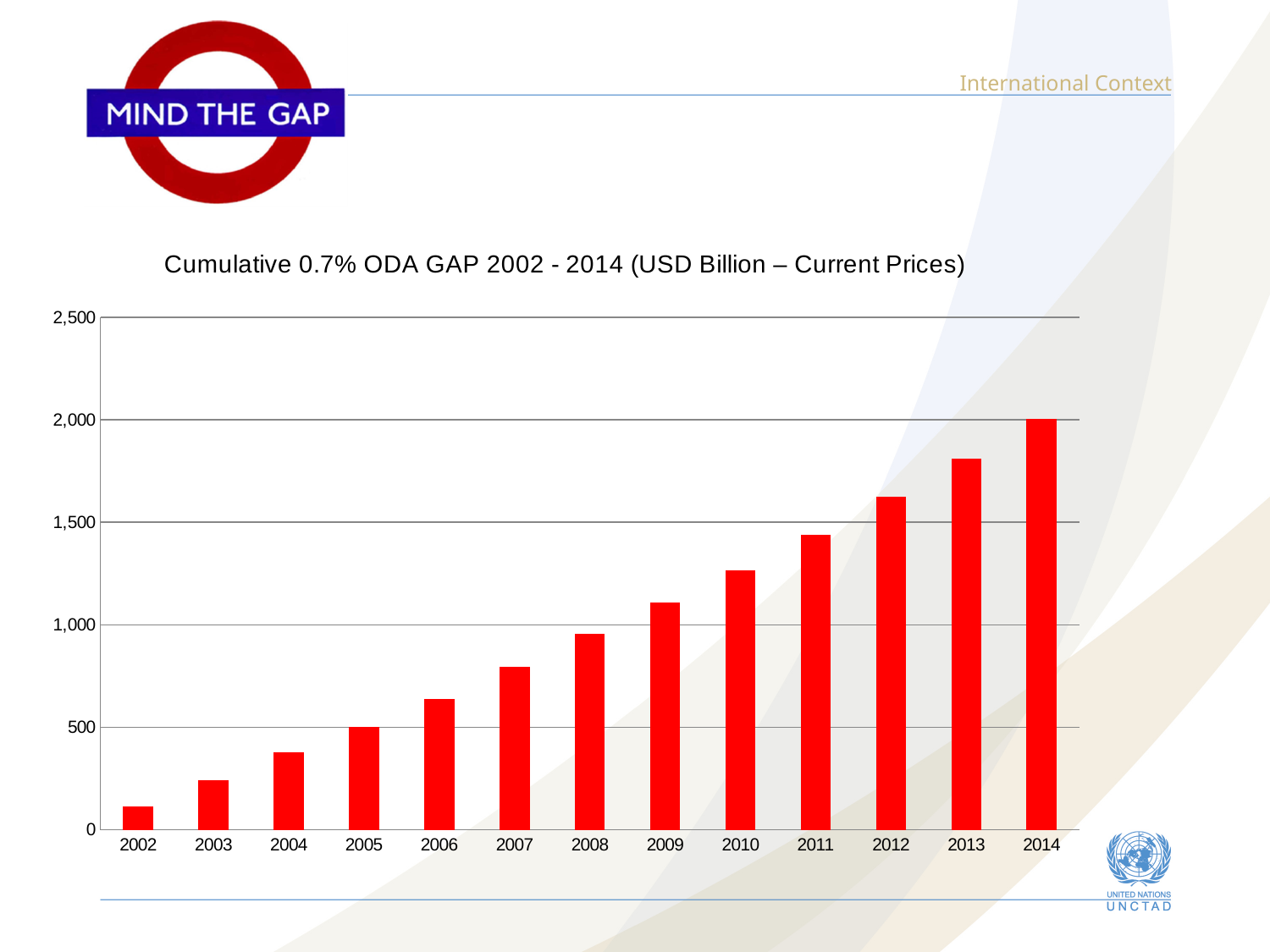
How many years are shown on the x axis of the chart? 13 Which year has the lowest cumulative ODA gap? 2002 Is the value for 2002 greater or less than 500? less What kind of chart is shown on the slide? bar chart Is the value for 2010 greater or less than 1,000? greater Is the value for 2012 greater or less than 1,500? greater What is the title of the chart? Cumulative 0.7% ODA GAP 2002 - 2014 (USD Billion – Current Prices) Which year has the highest cumulative ODA gap? 2014 Do the values rise or fall from 2002 to 2014? rise What colour are the bars in the chart? red Which is larger, the value for 2007 or the value for 2011? 2011